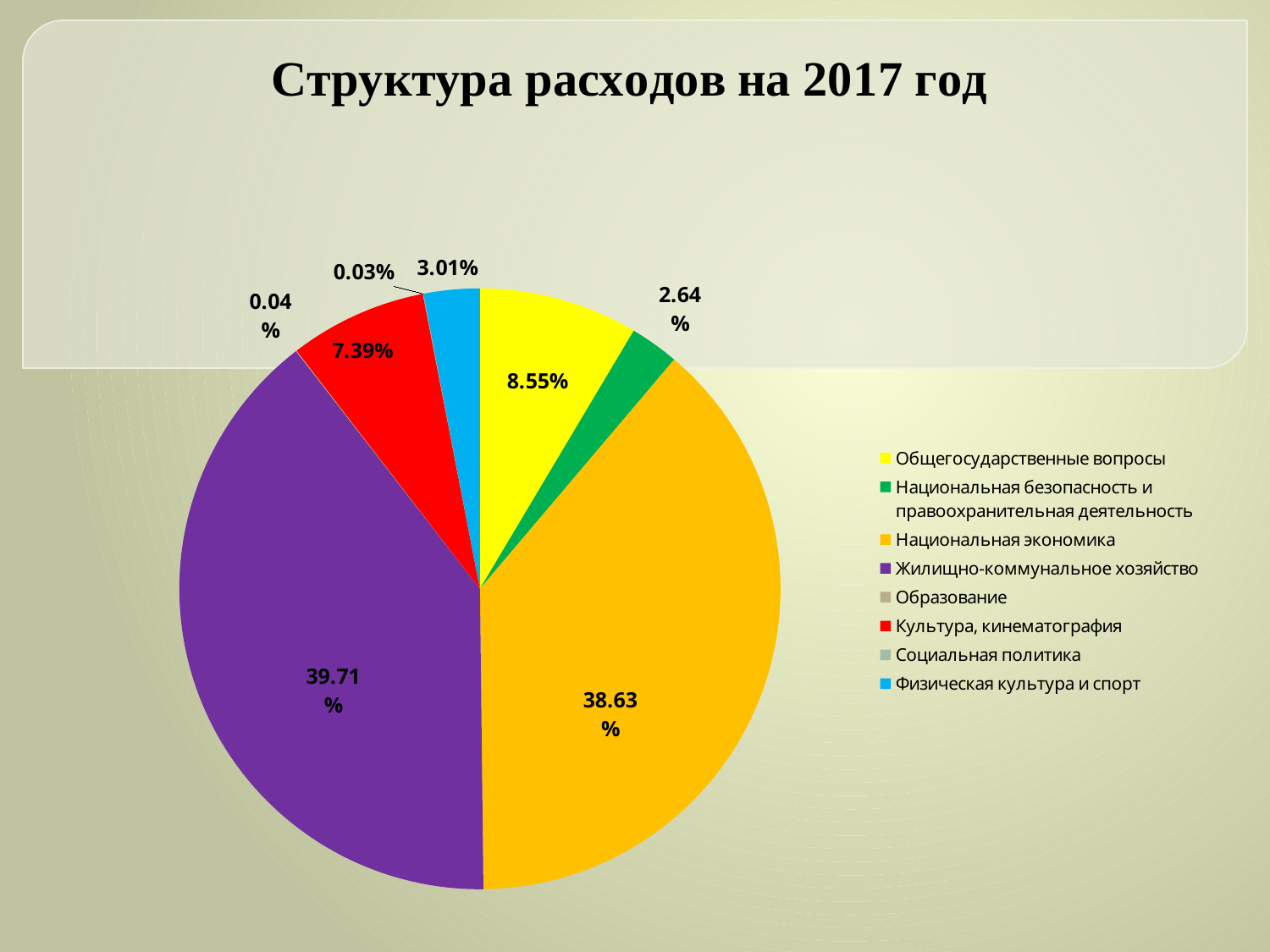
What share of expenditure goes to Национальная экономика? 38.63% What share of expenditure goes to Национальная безопасность и правоохранительная деятельность? 2.64% How many categories does the legend list? 8 What share of expenditure goes to Физическая культура и спорт? 3.01% What share of expenditure goes to Общегосударственные вопросы? 8.55% Which category has the largest share of expenditure? Жилищно-коммунальное хозяйство What share of expenditure goes to Культура, кинематография? 7.39% What share of expenditure goes to Жилищно-коммунальное хозяйство? 39.71% What is the title of the chart? Структура расходов на 2017 год Which is larger: the share for Общегосударственные вопросы or the share for Культура, кинематография? Общегосударственные вопросы What kind of chart is shown on the slide? Pie chart What is the difference between the shares for Жилищно-коммунальное хозяйство and Национальная экономика? 1.08%